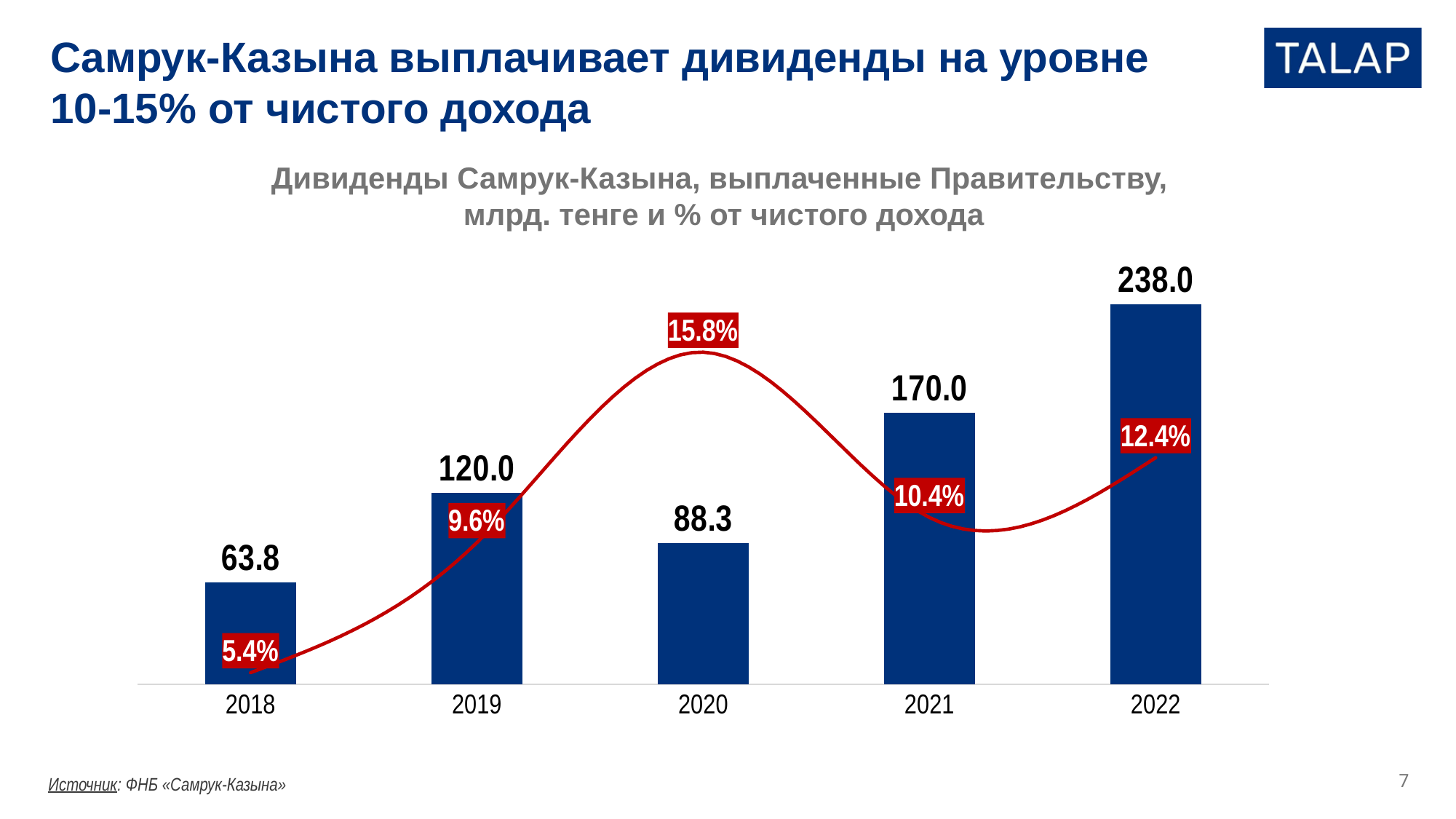
What percentage of net income do the dividends represent in 2020? 15.8% What is the source cited at the bottom of the slide? ФНБ «Самрук-Казына» What is the difference between the dividend amounts for 2022 and 2021? 68.0 What is the dividend value (in billion tenge) shown for 2022? 238.0 What is the dividend value shown for 2018? 63.8 Do the dividend amounts in billion tenge rise or fall from 2020 to 2022? Rise What type of chart is used to show the dividend amounts in billion tenge? Bar chart Which year has the lowest dividend amount in billion tenge? 2018 Which is larger, the dividend amount for 2019 or for 2020? 2019 Which year has the highest dividend amount in billion tenge? 2022 Which year has the highest dividend share of net income (%)? 2020 How many years are shown on the x axis of the chart? 5